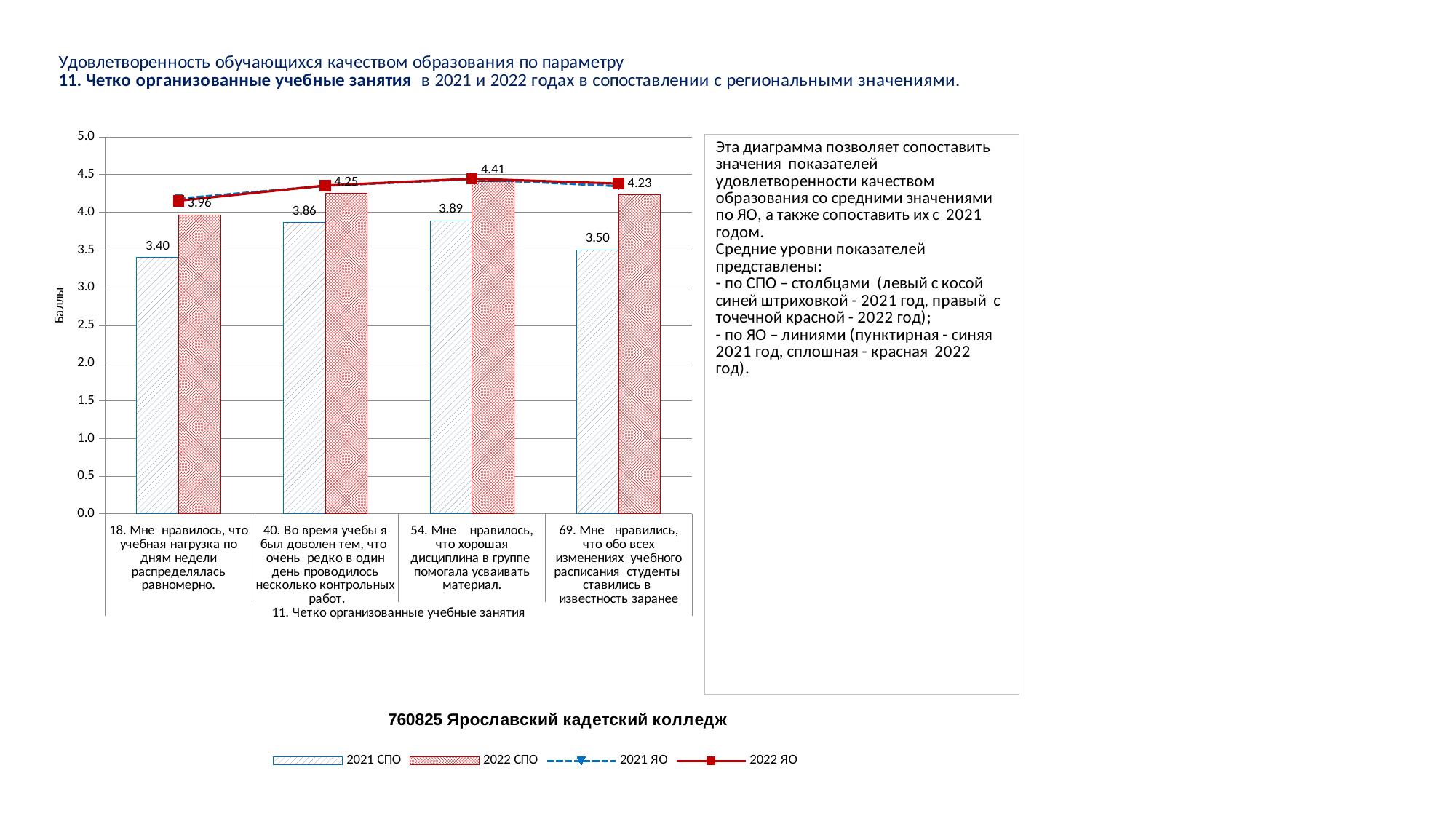
What is the difference between the 2022 СПО and 2021 СПО values for category 69? 0.73 Which is larger for category 40: the 2021 СПО value or the 2022 СПО value? 2022 СПО How many series does the legend list? 4 Is the 2021 СПО value for category 54 greater or less than 4.0? less What is the label of the vertical axis? Баллы How many categories are shown on the x axis? 4 What kind of chart is shown on the slide? Combined bar and line chart What is the value of the 2022 СПО bar for category 69 ("Мне нравились, что обо всех изменениях учебного расписания студенты ставились в известность заранее")? 4.23 What is the value of the 2022 СПО bar for category 54 ("Мне нравилось, что хорошая дисциплина в группе помогала усваивать материал")? 4.41 Which category has the highest 2022 СПО value? 54. Мне нравилось, что хорошая дисциплина в группе помогала усваивать материал. What is the value of the 2021 СПО bar for category 18 ("Мне нравилось, что учебная нагрузка по дням недели распределялась равномерно")? 3.40 Which category has the lowest 2021 СПО value? 18. Мне нравилось, что учебная нагрузка по дням недели распределялась равномерно.